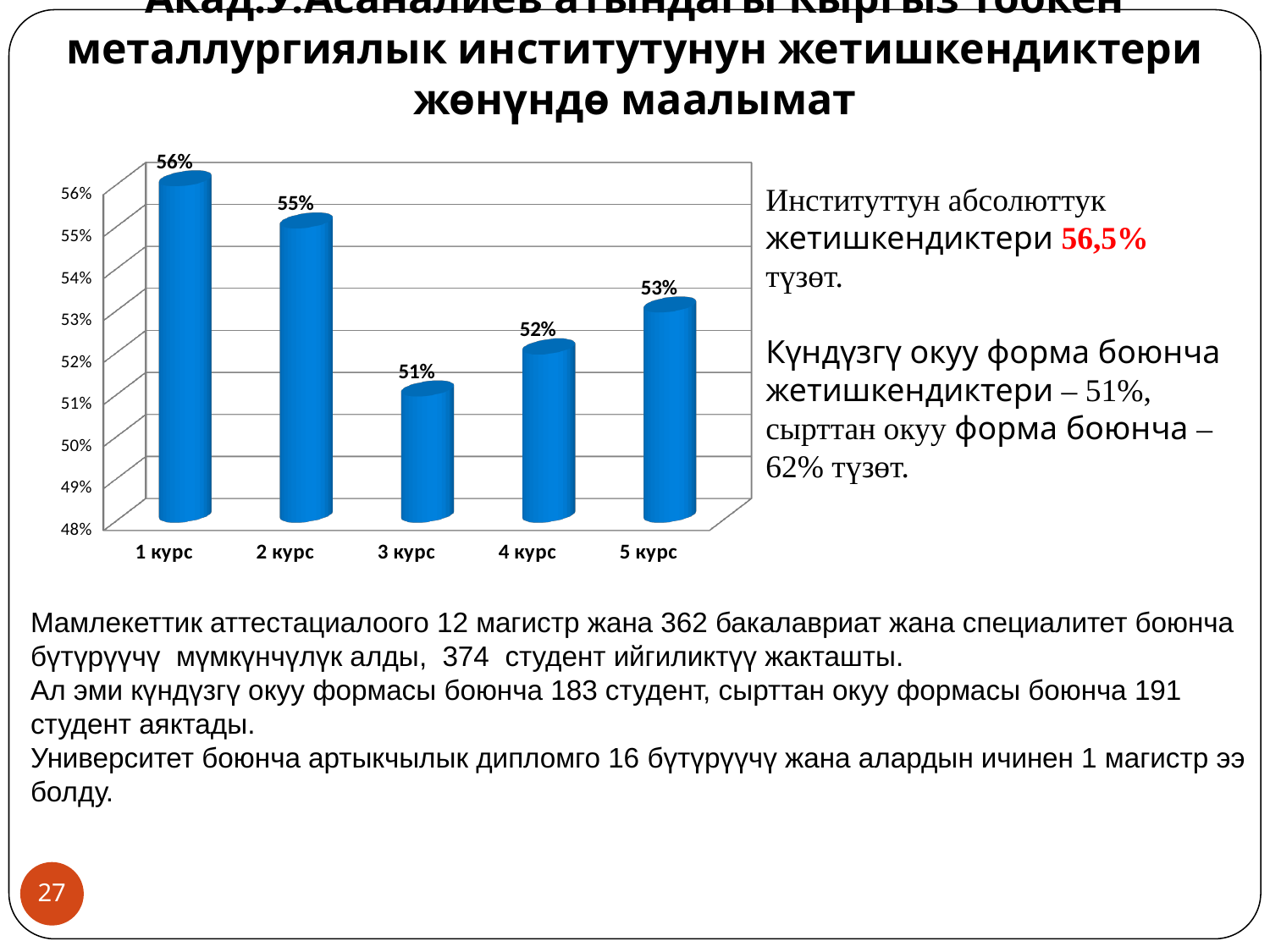
What is the value for 1 курс? 56% What is the difference between the values for 2 курс and 4 курс? 3% What is the value for 3 курс? 51% What is the value for 5 курс? 53% What is the difference between the values for 1 курс and 3 курс? 5% Which category has the highest value? 1 курс Do the values rise or fall from 3 курс to 5 курс? rise Which category has the lowest value? 3 курс What kind of chart is shown on the slide? bar chart Is the value for 2 курс greater or less than 53%? greater Which is larger, the value for 4 курс or the value for 5 курс? 5 курс How many categories are shown on the x axis? 5